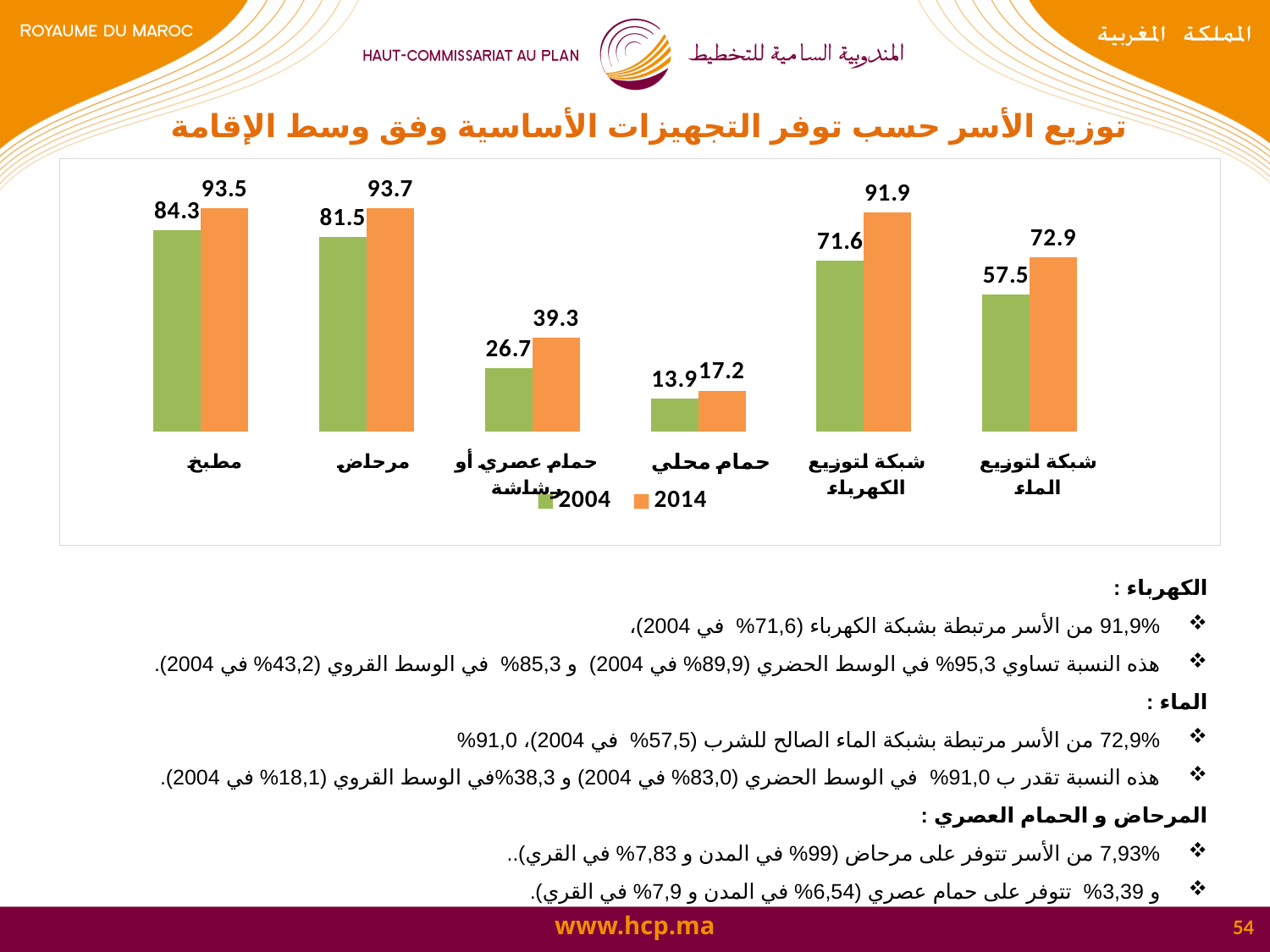
What kind of chart is shown on the slide? bar chart What is the 2014 value for شبكة لتوزيع الكهرباء? 91.9 How many categories are shown on the x axis? 6 Which category has the lowest 2004 value? حمام محلي Which series is shown in orange in the legend? 2014 Which is larger: the 2004 value for مطبخ or the 2004 value for مرحاض? مطبخ What is the 2004 value for حمام محلي? 13.9 What is the 2004 value for شبكة لتوزيع الماء? 57.5 Which category has the highest 2014 value? مرحاض How many series does the legend list? 2 What is the difference between the 2014 and 2004 values for مطبخ? 9.2 What is the difference between the 2014 and 2004 values for شبكة لتوزيع الكهرباء? 20.3